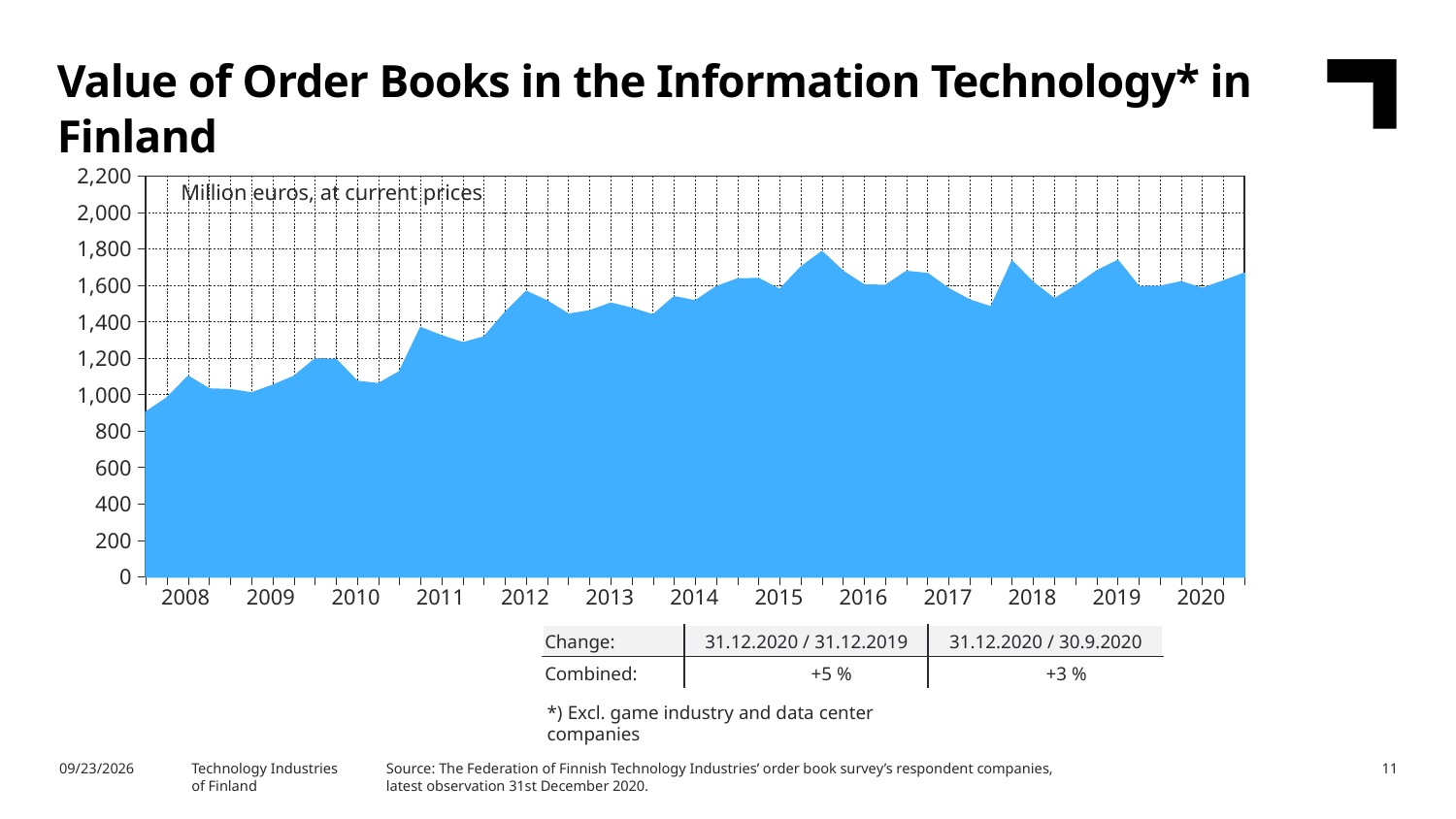
What is the highest value shown on the y axis of the chart? 2,200 Is the value at the end of 2020 greater or less than 1,400? greater Which is larger, the value at the start of 2008 or the value at the end of 2020? end of 2020 Is the value at the start of 2008 greater or less than 1,000? less Is the peak value reached around 2015 greater or less than 2,000? less Overall, do the values rise or fall from 2008 to 2020? rise In which year does the chart show its lowest value? 2008 What kind of chart is shown on the slide? area chart What is the combined change for 31.12.2020 / 31.12.2019 shown below the chart? +5 % What unit is stated for the values in the chart? Million euros, at current prices How many years are labelled on the x axis of the chart? 13